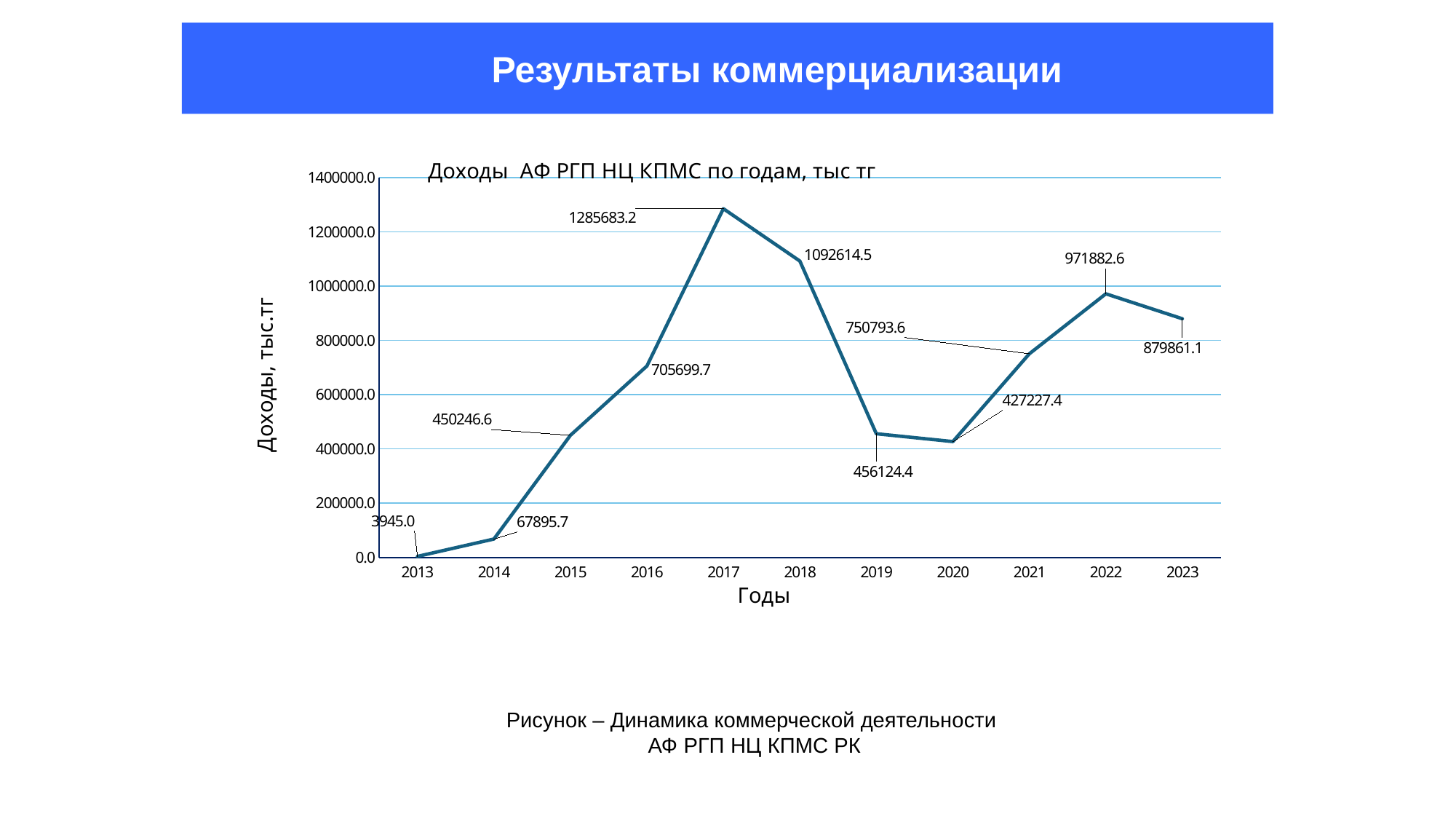
What is the difference between the values for 2022 and 2023? 92021.5 What kind of chart is shown on the slide? line chart What is the value for 2020? 427227.4 Do the values rise or fall from 2013 to 2017? rise Which is larger, the value for 2016 or the value for 2021? 2021 Which year has the lowest value? 2013 How many years are plotted on the chart? 11 What is the value for 2017? 1285683.2 What is the value for 2023? 879861.1 Which year has the highest value? 2017 What is the difference between the values for 2017 and 2018? 193068.7 Is the value for 2019 greater or less than 400000.0? greater